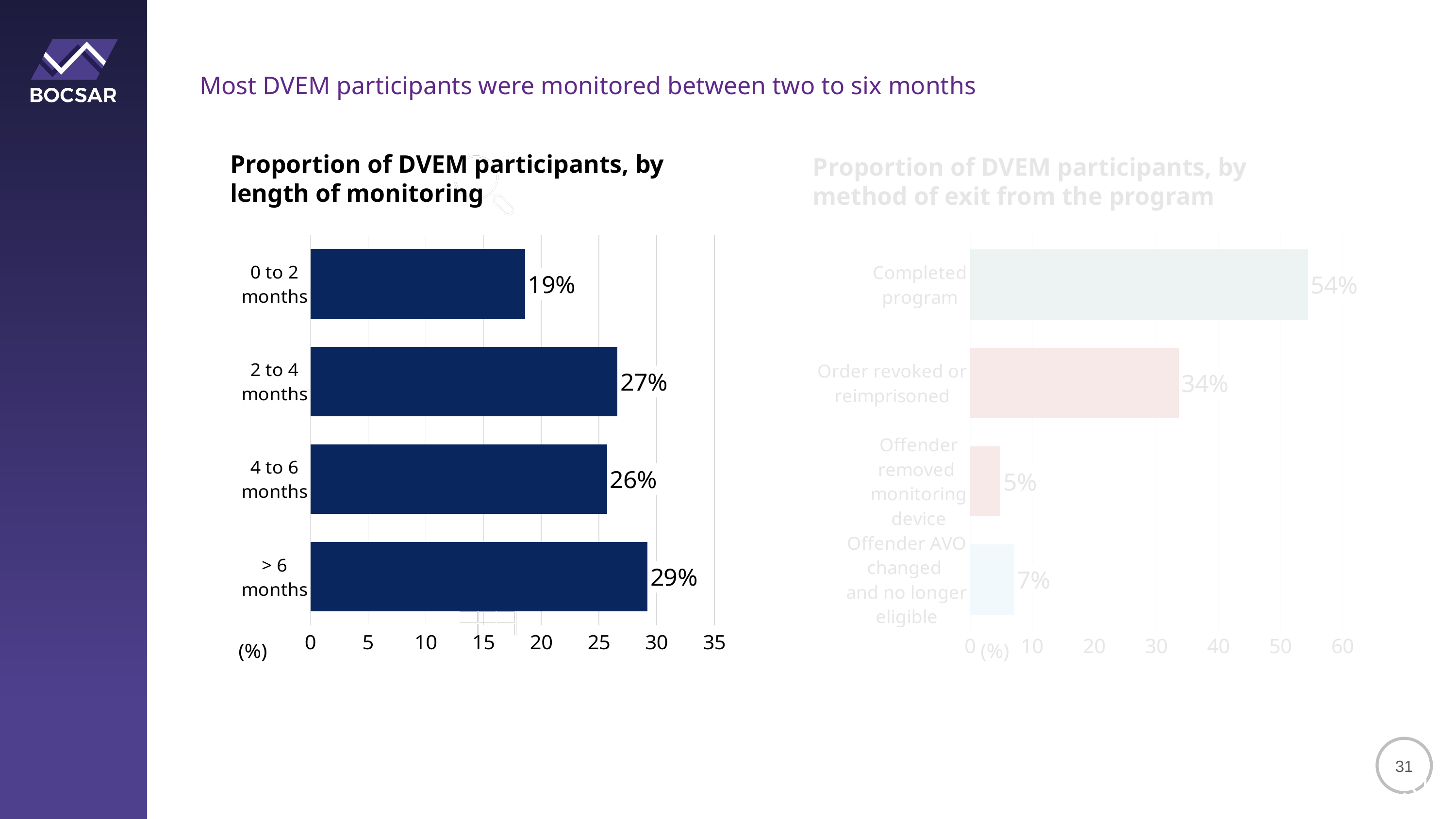
In the chart titled 'Proportion of DVEM participants, by length of monitoring', what is the value for '0 to 2 months'? 19% In the chart titled 'Proportion of DVEM participants, by length of monitoring', which is larger: the value for '2 to 4 months' or '0 to 2 months'? 2 to 4 months In the chart titled 'Proportion of DVEM participants, by length of monitoring', what is the difference between the values for '> 6 months' and '0 to 2 months'? 10% In the chart titled 'Proportion of DVEM participants, by length of monitoring', which category has the lowest value? 0 to 2 months In the chart titled 'Proportion of DVEM participants, by length of monitoring', what is the value for '> 6 months'? 29% In the chart titled 'Proportion of DVEM participants, by length of monitoring', what is the value for '2 to 4 months'? 27% In the chart titled 'Proportion of DVEM participants, by method of exit from the program', which category has the lowest value? Offender removed monitoring device In the chart titled 'Proportion of DVEM participants, by length of monitoring', how many categories are shown? 4 In the chart titled 'Proportion of DVEM participants, by length of monitoring', which category has the highest value? > 6 months In the chart titled 'Proportion of DVEM participants, by length of monitoring', what is the value for '4 to 6 months'? 26% What kind of chart is the chart titled 'Proportion of DVEM participants, by length of monitoring'? Bar chart In the chart titled 'Proportion of DVEM participants, by method of exit from the program', what is the value for 'Completed program'? 54%